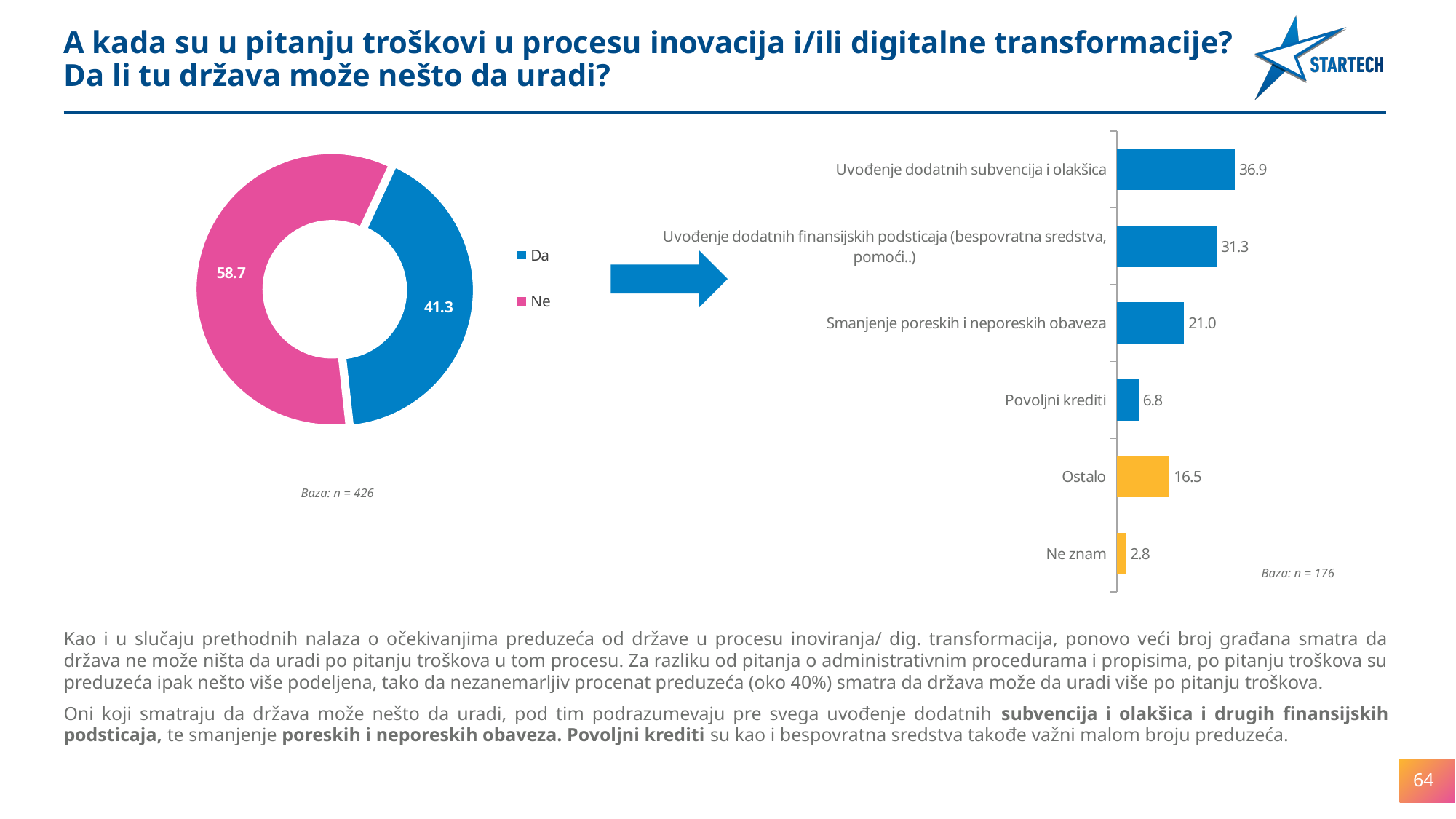
In the doughnut chart on the left, how many entries does the legend list? 2 In the doughnut chart on the left, what is the value for "Da"? 41.3 In the doughnut chart on the left, what is the difference between the "Ne" and "Da" values? 17.4 In the bar chart on the right, how many categories are shown? 6 In the doughnut chart on the left, which category is larger, "Da" or "Ne"? Ne In the bar chart on the right, what is the difference between "Uvođenje dodatnih subvencija i olakšica" and "Smanjenje poreskih i neporeskih obaveza"? 15.9 In the bar chart on the right, which category has the lowest value? Ne znam In the bar chart on the right, what is the value for "Povoljni krediti"? 6.8 In the doughnut chart on the left, what is the value for "Ne"? 58.7 In the bar chart on the right, what is the value for "Uvođenje dodatnih subvencija i olakšica"? 36.9 In the bar chart on the right, which category has the highest value? Uvođenje dodatnih subvencija i olakšica What type of chart is shown on the right side of the slide? Bar chart